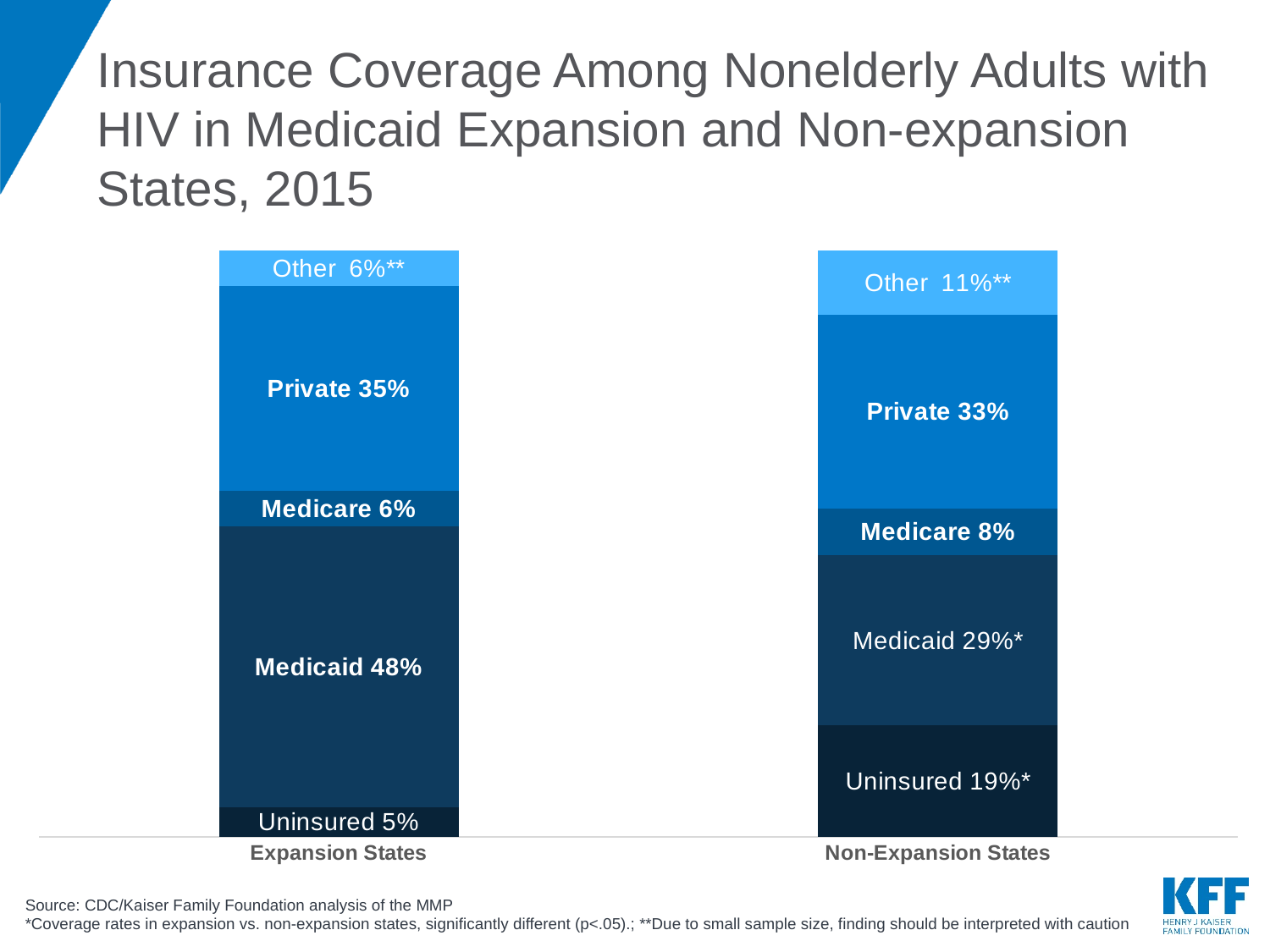
What is the difference in the uninsured rate between Non-Expansion States and Expansion States? 14 percentage points What is the uninsured rate among nonelderly adults with HIV in Non-Expansion States? 19% What percentage of nonelderly adults with HIV in Non-Expansion States have private coverage? 33% Which has a larger 'Other' coverage share, Expansion States or Non-Expansion States? Non-Expansion States Which coverage type is the largest segment in the Expansion States bar? Medicaid What share of nonelderly adults with HIV in Expansion States are covered by Medicaid? 48% Which coverage type is the smallest segment in the Expansion States bar? Uninsured What is the total of all segments in the Non-Expansion States bar? 100% What is the Medicare share for Expansion States? 6% How many state groups (bars) are shown in the chart? 2 How much higher is the Medicaid share in Expansion States than in Non-Expansion States? 19 percentage points What type of chart is shown on the slide? Stacked bar chart